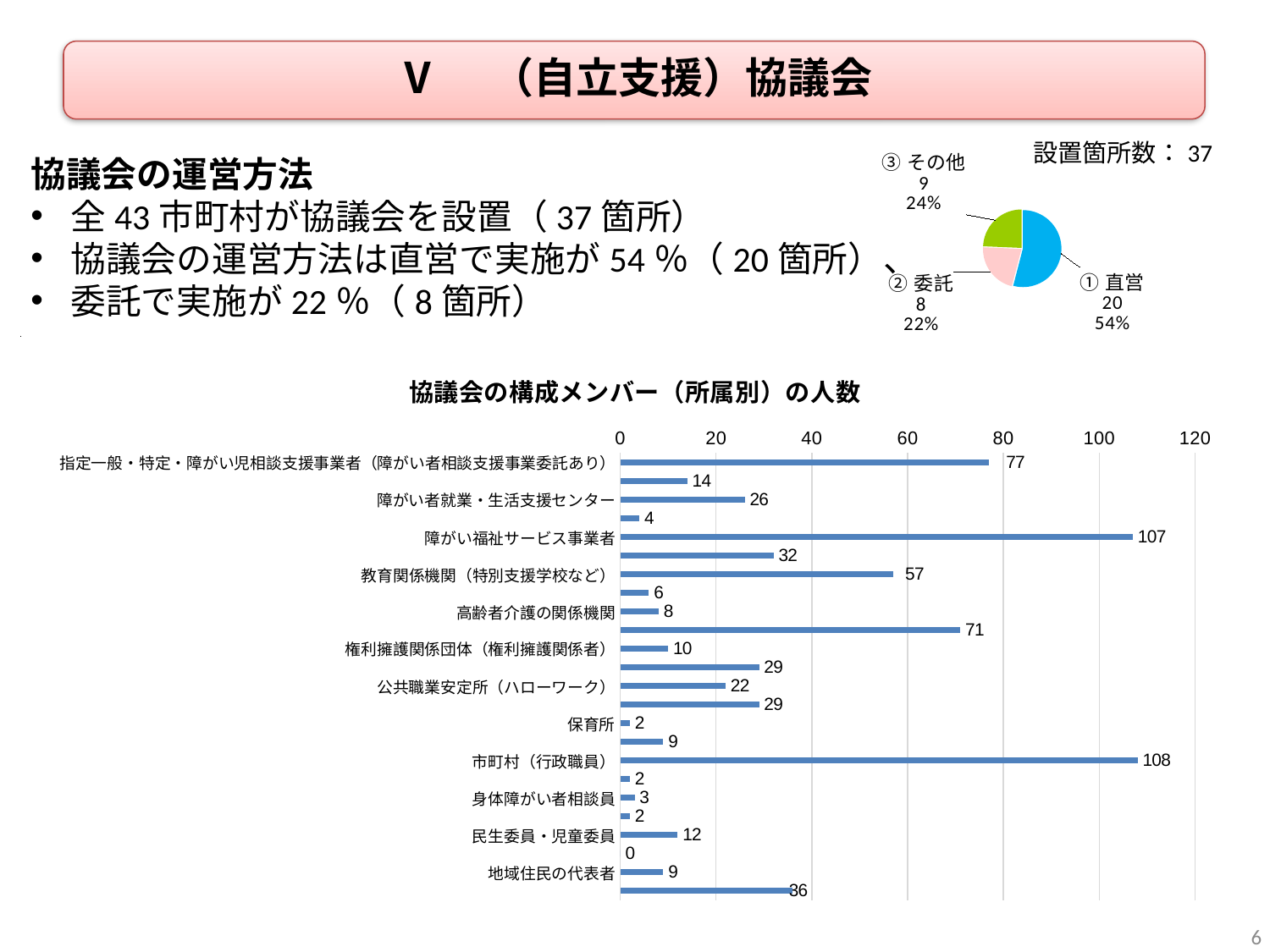
In the chart titled 協議会の構成メンバー（所属別）の人数, is the value for 市町村（行政職員） greater or less than 100? greater In the chart titled 協議会の構成メンバー（所属別）の人数, which is larger, the value for 障がい者就業・生活支援センター or the value for 公共職業安定所（ハローワーク）? 障がい者就業・生活支援センター In the pie chart at the top right, how many slices are there? 3 In the chart titled 協議会の構成メンバー（所属別）の人数, which category has the highest value? 市町村（行政職員） In the chart titled 協議会の構成メンバー（所属別）の人数, what is the value for 教育関係機関（特別支援学校など）? 57 In the pie chart at the top right, what is the difference between the values for ③ その他 and ② 委託? 1 What kind of chart is the chart titled 協議会の構成メンバー（所属別）の人数? bar chart In the pie chart at the top right, what is the value for ① 直営? 20 In the chart titled 協議会の構成メンバー（所属別）の人数, what is the difference between the values for 障がい福祉サービス事業者 and 指定一般・特定・障がい児相談支援事業者（障がい者相談支援事業委託あり）? 30 In the pie chart at the top right, which slice is the largest? ① 直営 In the chart titled 協議会の構成メンバー（所属別）の人数, what is the value for 市町村（行政職員）? 108 In the pie chart at the top right, what share of the pie does ② 委託 represent? 22%